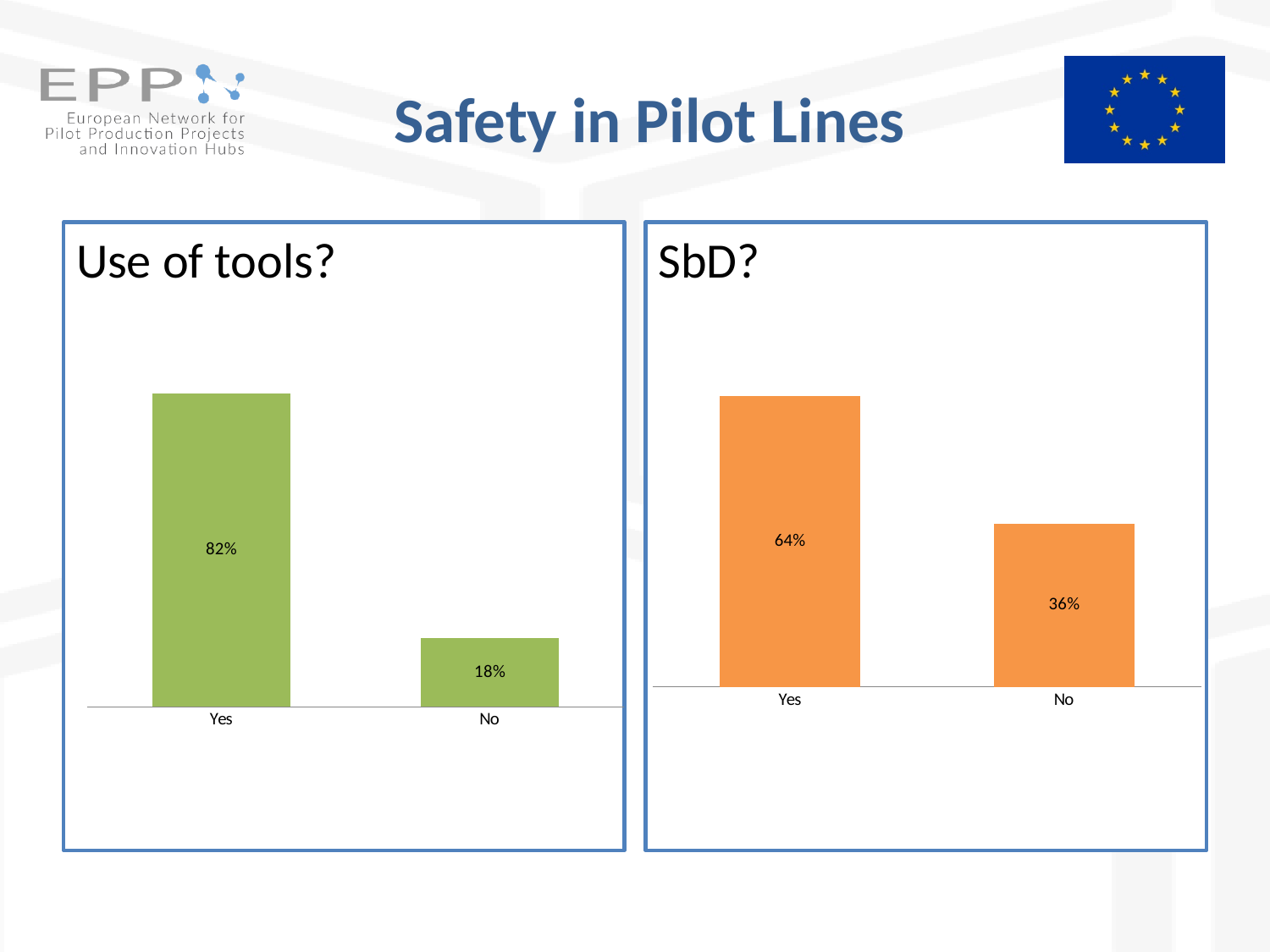
In the 'Use of tools?' chart, what is the difference between the Yes and No values? 64% In the 'SbD?' chart, which category has the lowest value? No What kind of chart is the 'SbD?' chart? Bar chart How many categories does the 'Use of tools?' chart show? 2 In the 'Use of tools?' chart, what is the value for Yes? 82% In the 'SbD?' chart, what is the value for Yes? 64% In the 'SbD?' chart, what is the value for No? 36% In the 'Use of tools?' chart, what is the value for No? 18% In the 'SbD?' chart, what is the difference between the Yes and No values? 28% What colour are the bars in the 'Use of tools?' chart? Green In the 'Use of tools?' chart, which category has the highest value? Yes In the 'SbD?' chart, which is larger, Yes or No? Yes